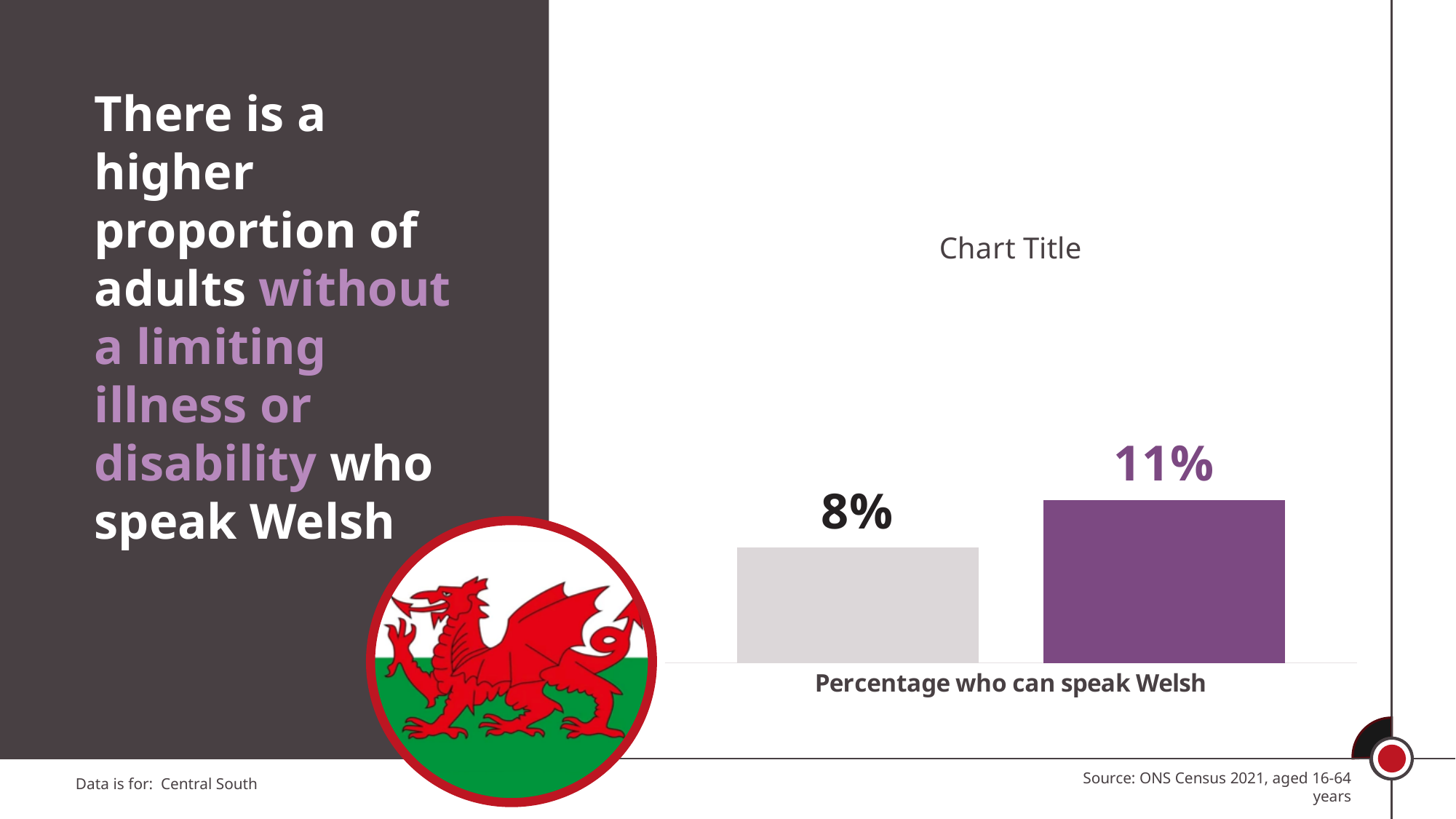
What is the difference between the purple bar's value and the grey bar's value? 3% What is the title displayed above the chart? Chart Title What is the value shown on the purple bar? 11% Which bar has the higher value, the grey bar or the purple bar? the purple bar What is the value of the right-hand bar in the chart? 11% What is the value shown on the grey bar? 8% Which bar shows the lowest value in the chart? the grey bar (8%) What type of chart is shown on the slide? bar chart What is the category label shown beneath the bars? Percentage who can speak Welsh What is the value of the left-hand bar in the chart? 8% How many bars are plotted in the chart? 2